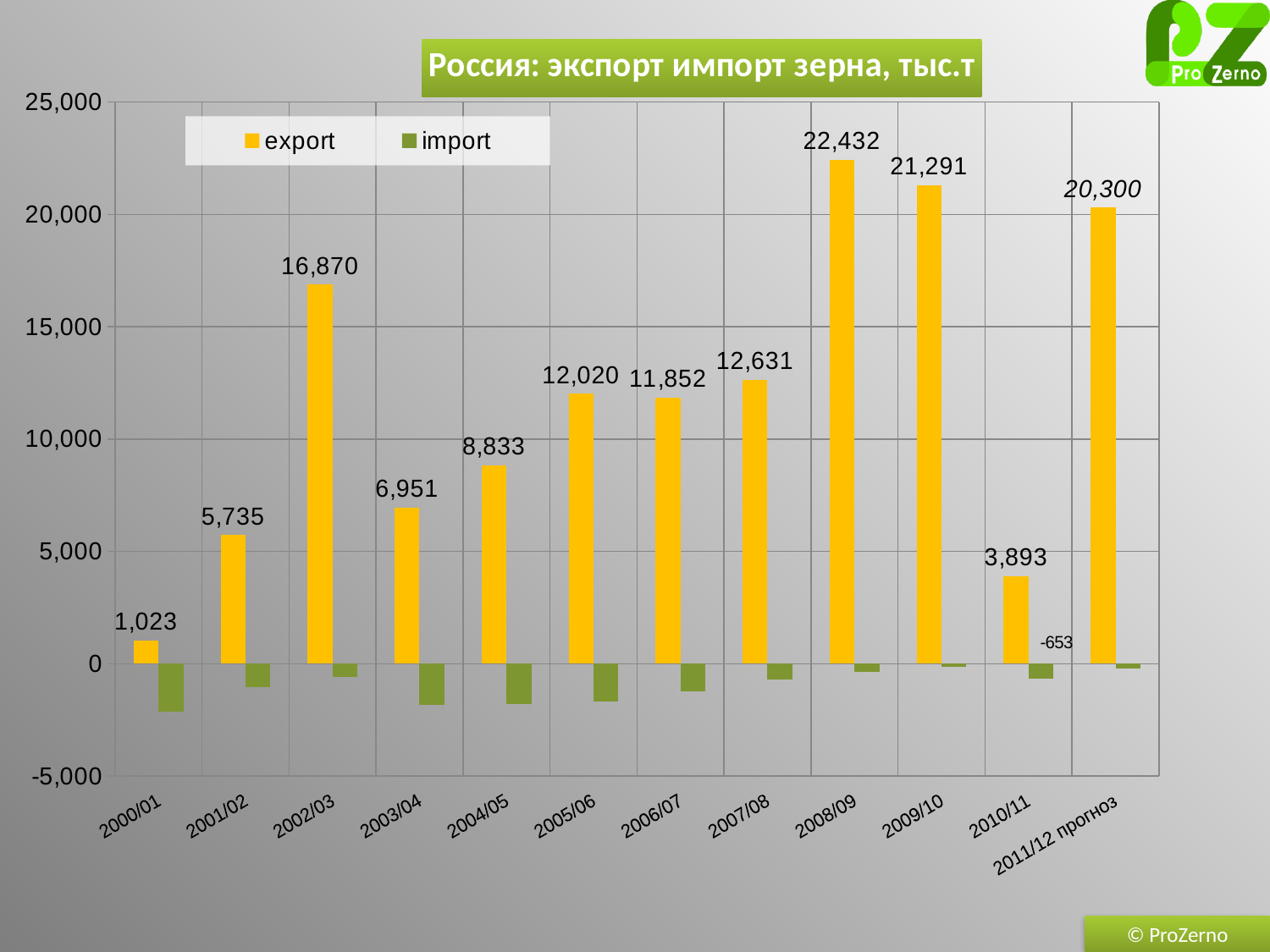
What is the export value for 2002/03? 16,870 Which season has the lowest export value? 2000/01 Which is larger, the export value for 2005/06 or for 2006/07? 2005/06 What is the export value for 2008/09? 22,432 Is the import value for 2000/01 greater or less than -5,000? greater How many seasons are shown on the x axis? 12 What is the export value for 2011/12 прогноз? 20,300 What is the import value for 2010/11? -653 How many series does the legend list? 2 What kind of chart is shown on the slide? bar chart Which season has the highest export value? 2008/09 What is the difference between the export values for 2008/09 and 2009/10? 1,141